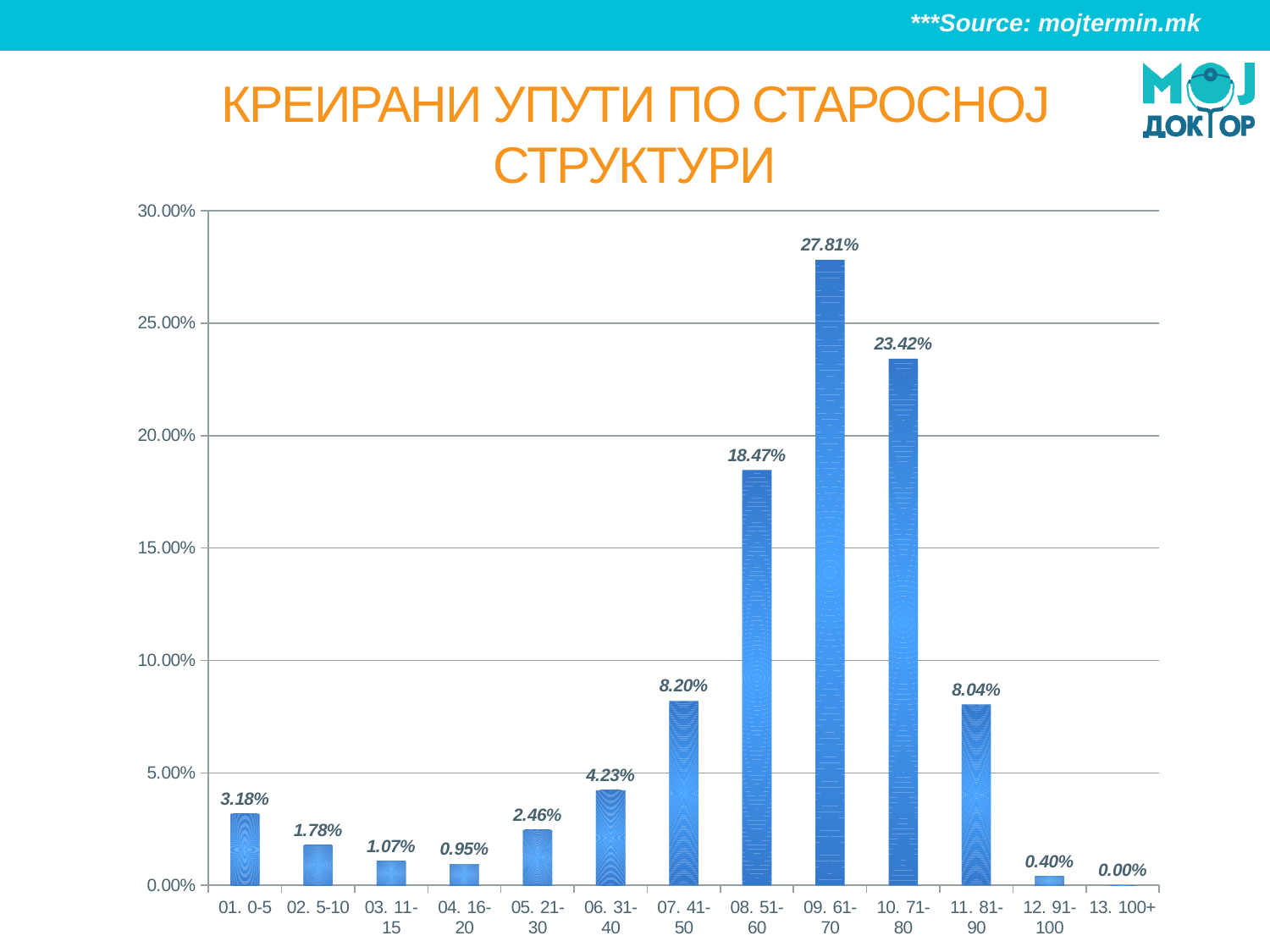
Which age group has the highest value? 09. 61-70 What is the difference between the values for 09. 61-70 and 10. 71-80? 4.39% What is the difference between the values for 08. 51-60 and 07. 41-50? 10.27% What kind of chart is shown on the slide? bar chart What is the value for the 09. 61-70 age group? 27.81% What is the value for the 12. 91-100 age group? 0.40% Is the value for 08. 51-60 greater or less than 20.00%? less Which age group has the lowest value? 13. 100+ What is the title of the chart? КРЕИРАНИ УПУТИ ПО СТАРОСНОЈ СТРУКТУРИ How many age groups are shown on the x axis? 13 What is the value for the 04. 16-20 age group? 0.95% Which is larger, the value for 06. 31-40 or the value for 11. 81-90? 11. 81-90